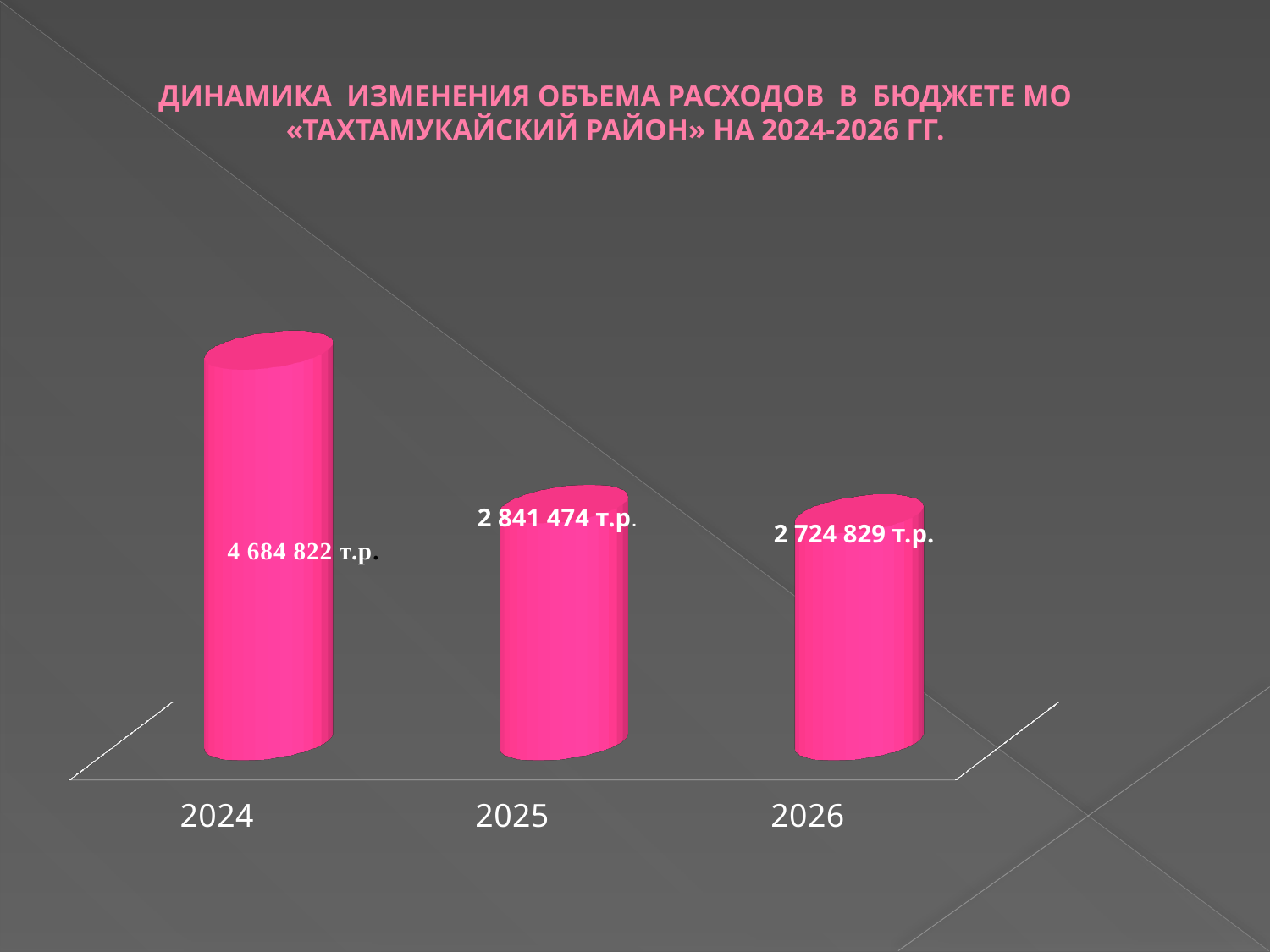
What is the value shown for 2025? 2 841 474 т.р. What is the difference between the values for 2025 and 2026? 116 645 т.р. Do the values rise or fall from 2024 to 2026? Fall What is the difference between the values for 2024 and 2026? 1 959 993 т.р. What is the value shown for 2026? 2 724 829 т.р. Which year has the lowest value? 2026 What kind of chart is shown on the slide? Bar chart What is the difference between the values for 2024 and 2025? 1 843 348 т.р. How many years are shown on the chart? 3 What is the value shown for 2024? 4 684 822 т.р. Which year has the highest value? 2024 Which is larger, the value for 2025 or the value for 2026? 2025